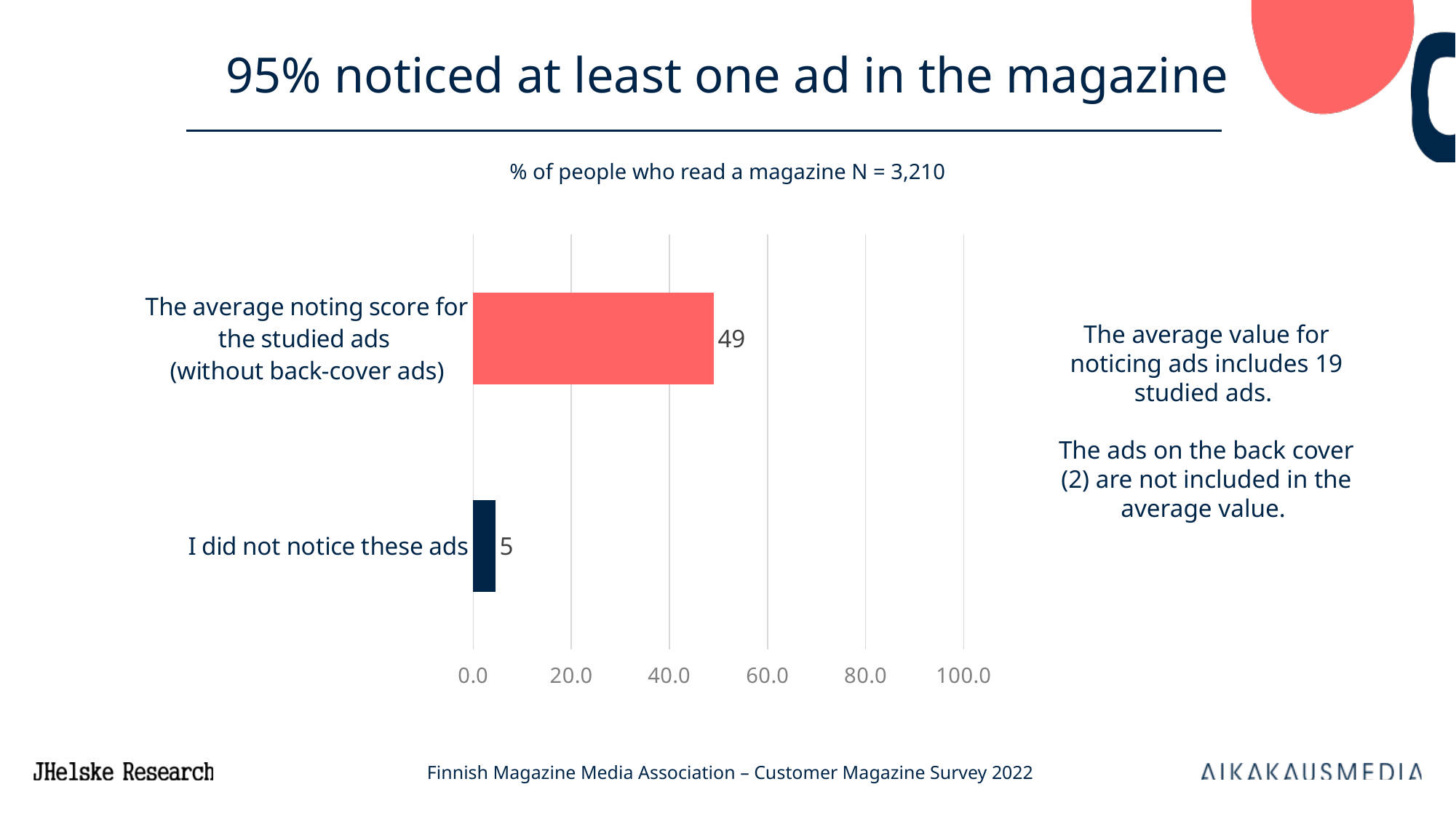
What is the value for "I did not notice these ads"? 5 Which is larger: the average noting score for the studied ads or the value for "I did not notice these ads"? The average noting score for the studied ads (without back-cover ads) What is the difference between the average noting score for the studied ads and the value for "I did not notice these ads"? 44 Which category has the lowest value? I did not notice these ads Is the value for "I did not notice these ads" greater or less than 20.0? less What is the highest value shown on the x axis? 100.0 What kind of chart is shown on the slide? Bar chart What is the chart's subtitle describing the data? % of people who read a magazine N = 3,210 How many categories are shown in the chart? 2 Which category has the highest value? The average noting score for the studied ads (without back-cover ads) What is the value for "The average noting score for the studied ads (without back-cover ads)"? 49 Is the value for "The average noting score for the studied ads" greater or less than 40.0? greater